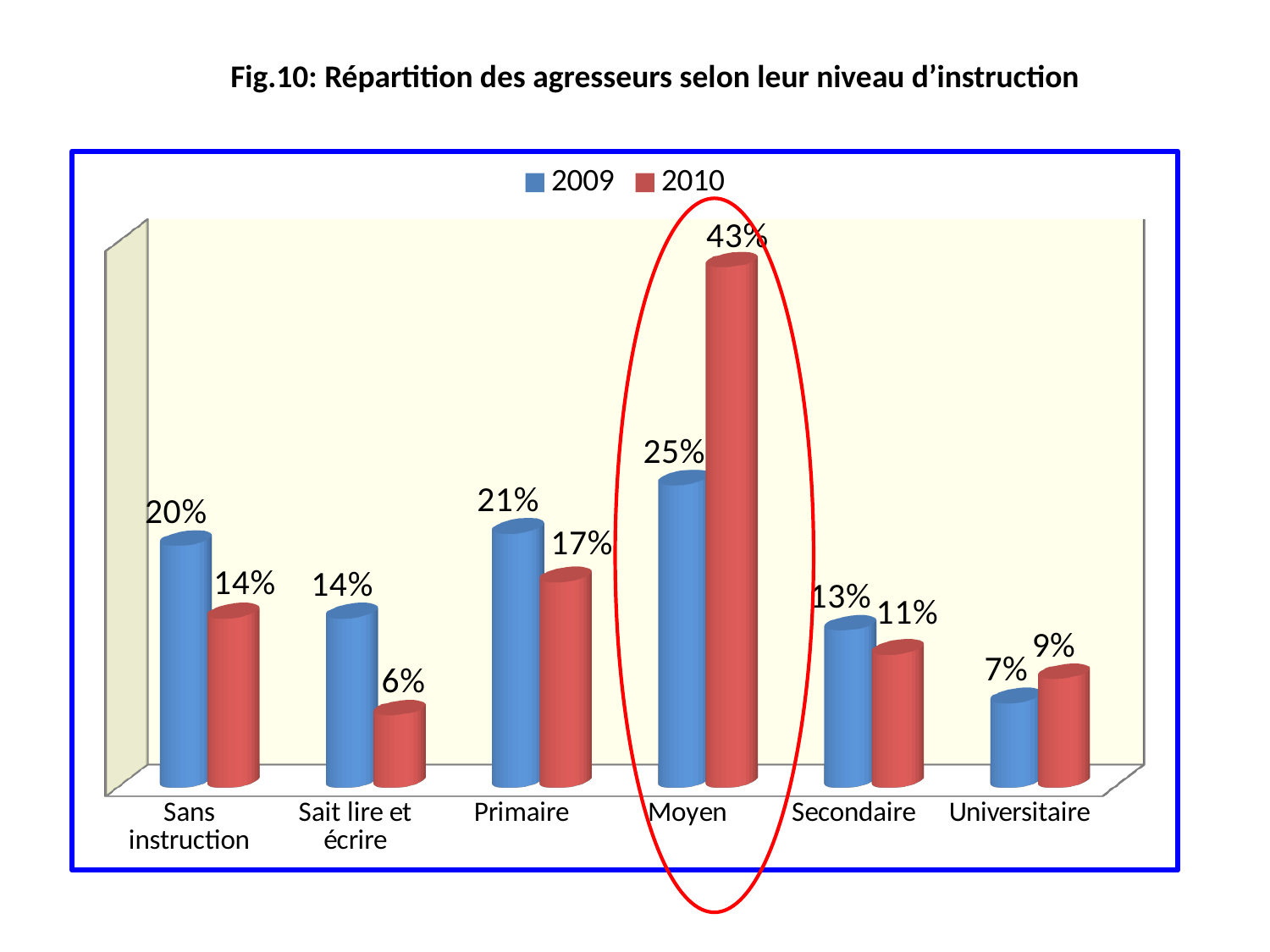
Which is larger for Primaire, the 2009 value or the 2010 value? 2009 What is the 2010 value for Sait lire et écrire? 6% Which category has the highest 2010 value? Moyen Which category is circled in red on the chart? Moyen What kind of chart is shown? Bar chart What is the 2010 value for Moyen? 43% What is the difference between the 2010 and 2009 values for Moyen? 18% What is the 2009 value for Universitaire? 7% How many categories are shown on the x axis? 6 What is the 2009 value for Sans instruction? 20% How many series does the legend list? 2 Which category has the lowest 2009 value? Universitaire